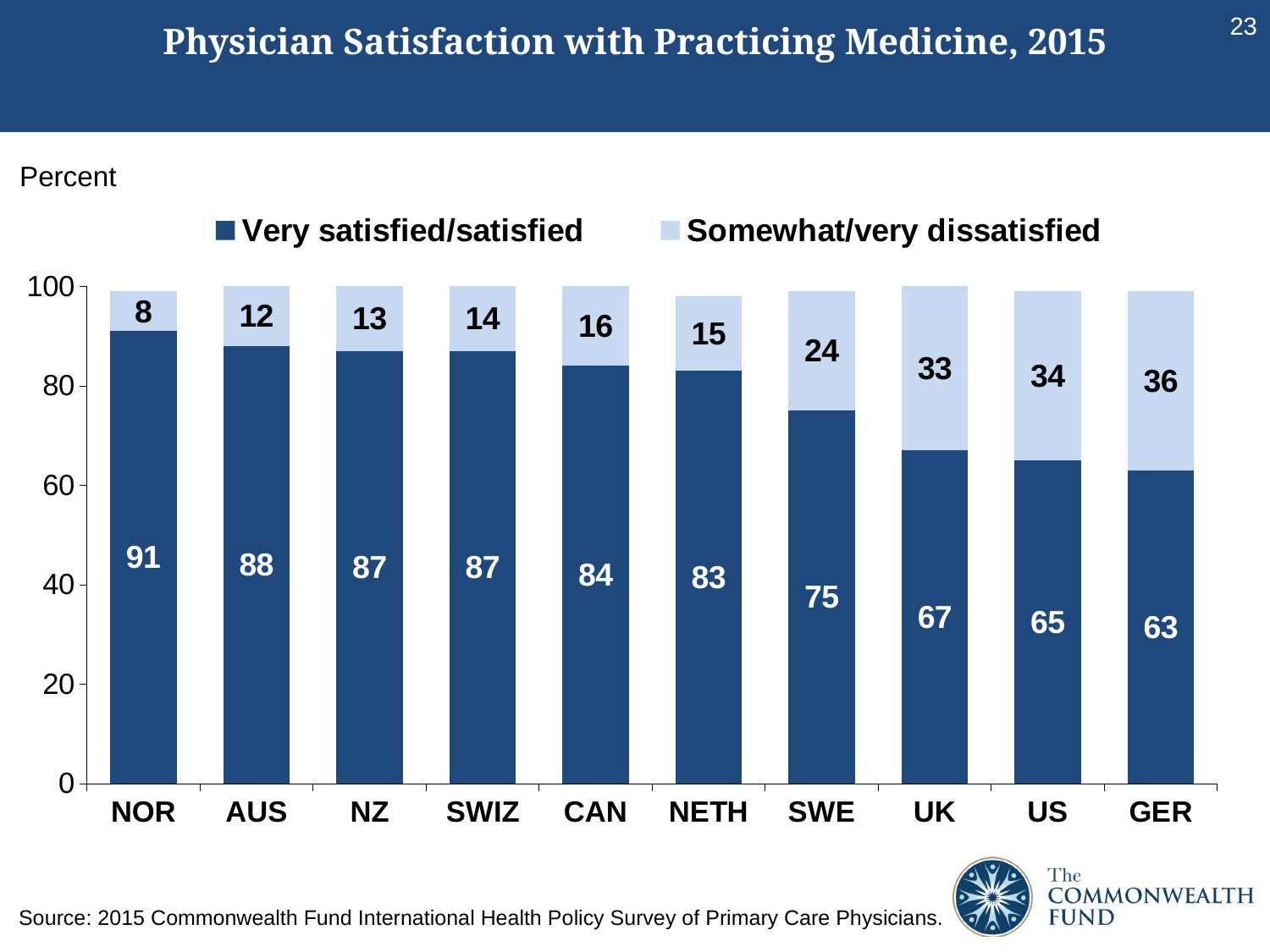
Which country has the lowest Very satisfied/satisfied value? GER What is the Somewhat/very dissatisfied value for GER? 36 What is the total of the stacked bar for SWE? 99 Which country has the highest Very satisfied/satisfied value? NOR How many countries are shown on the x axis? 10 What is the title of the chart? Physician Satisfaction with Practicing Medicine, 2015 Do the Very satisfied/satisfied values rise or fall from left to right along the x axis? Fall What is the difference between the Very satisfied/satisfied values for NOR and GER? 28 Which has a larger Somewhat/very dissatisfied value, SWE or UK? UK How many series does the legend list? 2 What percentage of physicians in NOR are very satisfied/satisfied? 91 What kind of chart is shown on the slide? Stacked bar chart